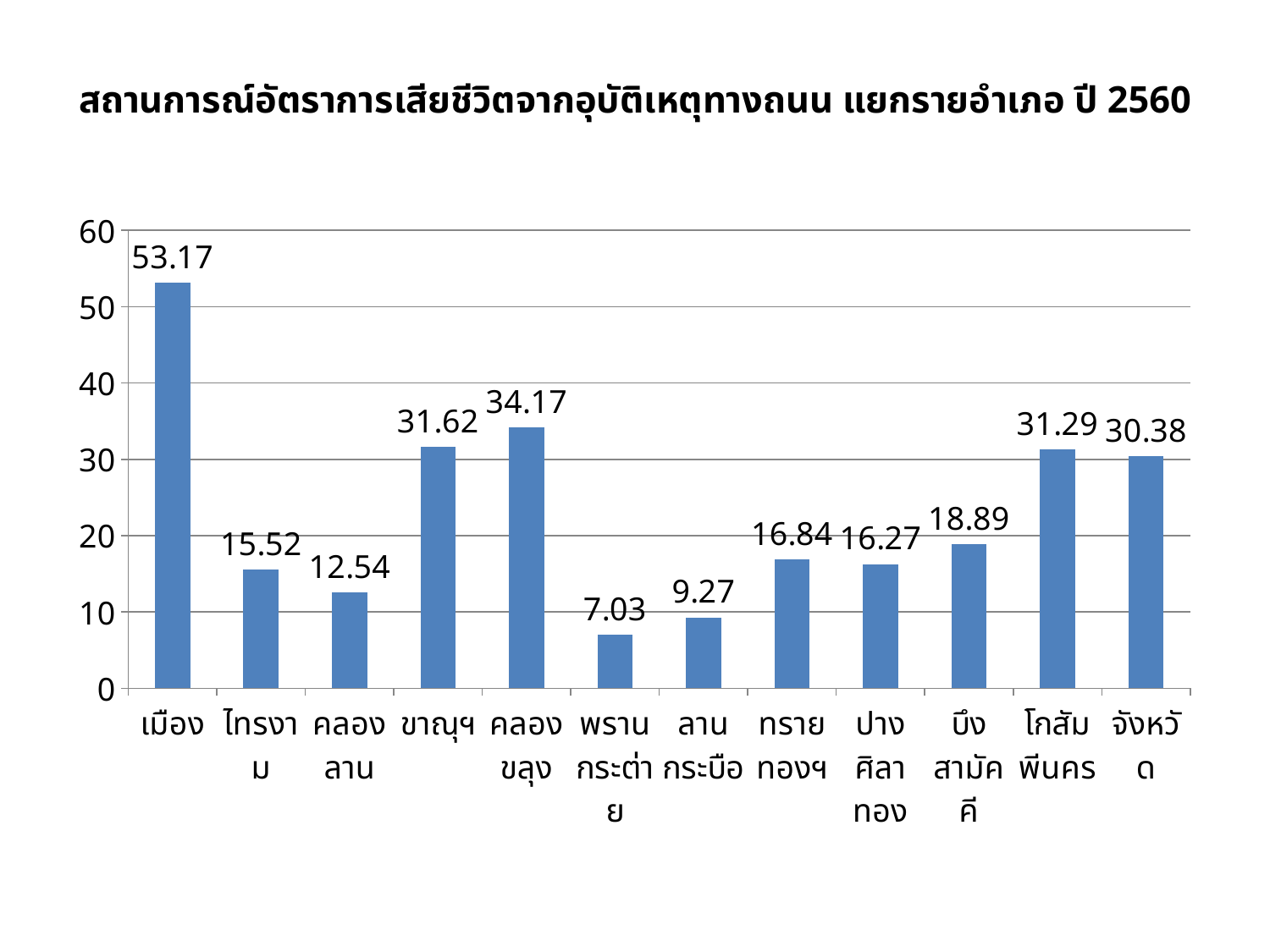
What is the value for เมือง? 53.17 What is the value for จังหวัด? 30.38 How many categories are shown on the x axis? 12 What is the value for พรานกระต่าย? 7.03 What kind of chart is shown on the slide? bar chart What is the difference between the values for เมือง and จังหวัด? 22.79 Is the value for บึงสามัคคี greater or less than 20? less Which category has the lowest value? พรานกระต่าย Which is larger, the value for ทรายทองฯ or the value for ปางศิลาทอง? ทรายทองฯ Which category has the highest value? เมือง What is the title of the chart? สถานการณ์อัตราการเสียชีวิตจากอุบัติเหตุทางถนน แยกรายอำเภอ ปี 2560 What is the difference between the values for คลองขลุง and ขาณุฯ? 2.55